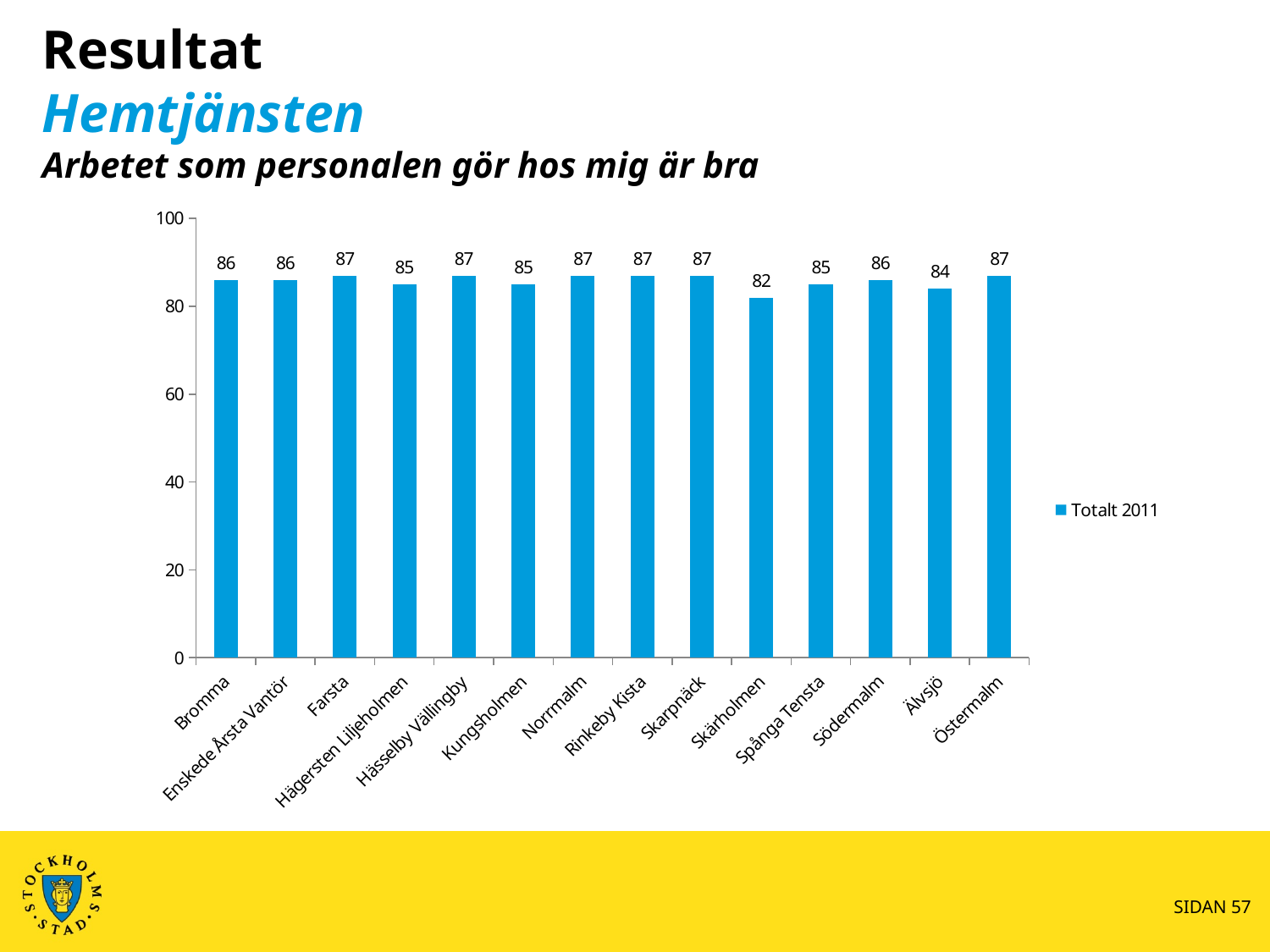
Which is larger, the value for Norrmalm or the value for Kungsholmen? Norrmalm How many series does the legend list? 1 How many categories are shown on the x axis? 14 What kind of chart is shown on the slide? bar chart What is the value for Bromma? 86 Which category has the lowest value? Skärholmen What is the value for Älvsjö? 84 What is the value for Skärholmen? 82 Is the value for Skärholmen greater or less than 80? greater What is the difference between the values for Bromma and Älvsjö? 2 What is the difference between the values for Farsta and Skärholmen? 5 What is the value for Spånga Tensta? 85